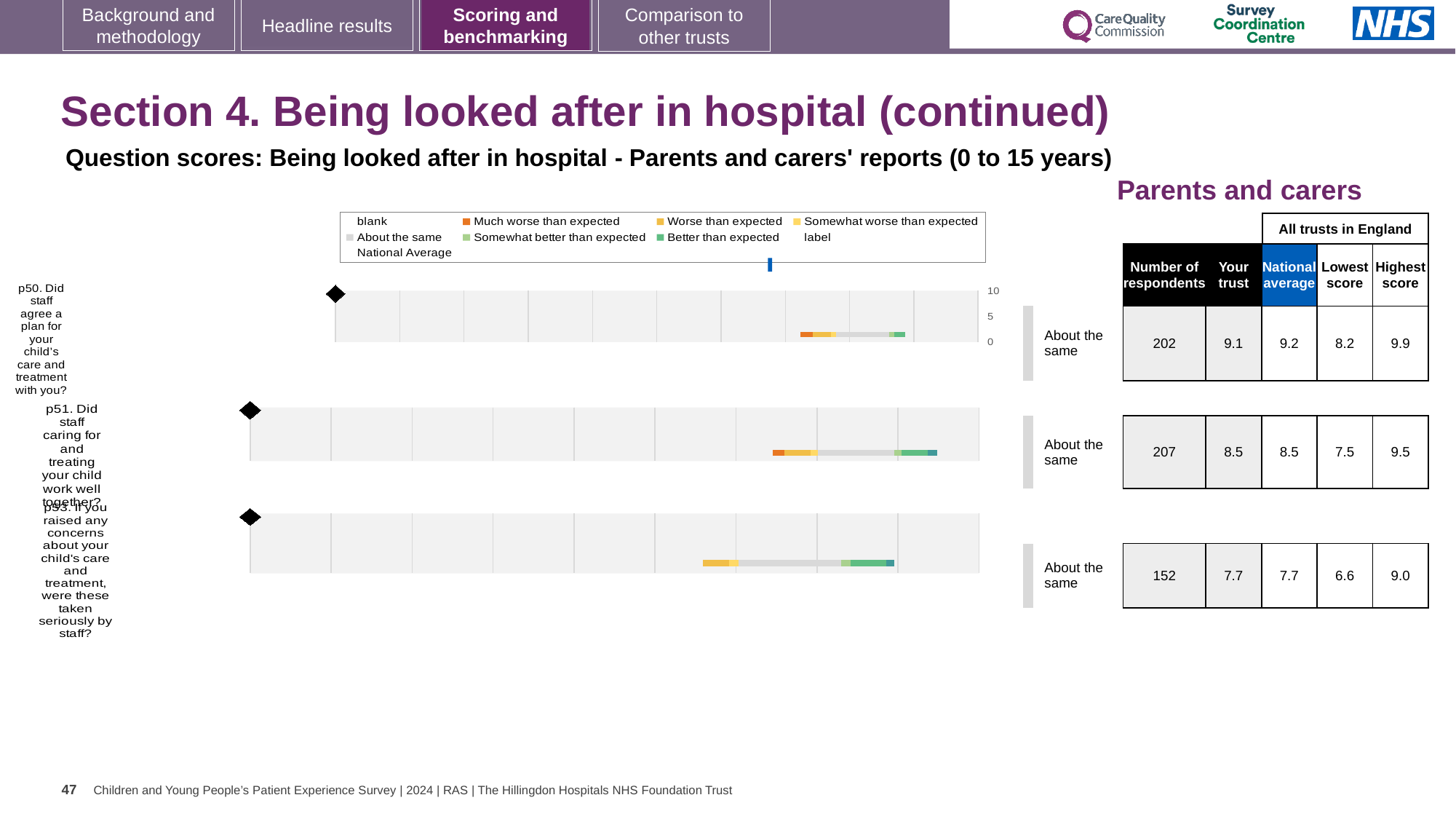
Which question has the lowest 'Your trust' score in the table: p50, p51 or p53? p53 What kind of chart is used to show the benchmarking results for each question on this slide? bar chart According to the table, what is the number of respondents for p53 (If you raised any concerns about your child's care and treatment, were these taken seriously by staff?)? 152 According to the table, what is the 'Your trust' score for p50 (Did staff agree a plan for your child's care and treatment with you?)? 9.1 Is the 'Your trust' score for p51 larger or smaller than the 'Your trust' score for p53? larger What is the difference between the 'Your trust' scores for p50 and p51? 0.6 Which question has the highest 'Your trust' score in the table: p50, p51 or p53? p50 How many question charts (p50, p51, p53) are shown on the slide? 3 Which legend entry is shown in orange? Much worse than expected What is the highest tick value shown on the axis of the p50 chart? 10 What benchmark category is shown next to the p53 chart? About the same According to the table, what is the national average for p51 (Did staff caring for and treating your child work well together?)? 8.5